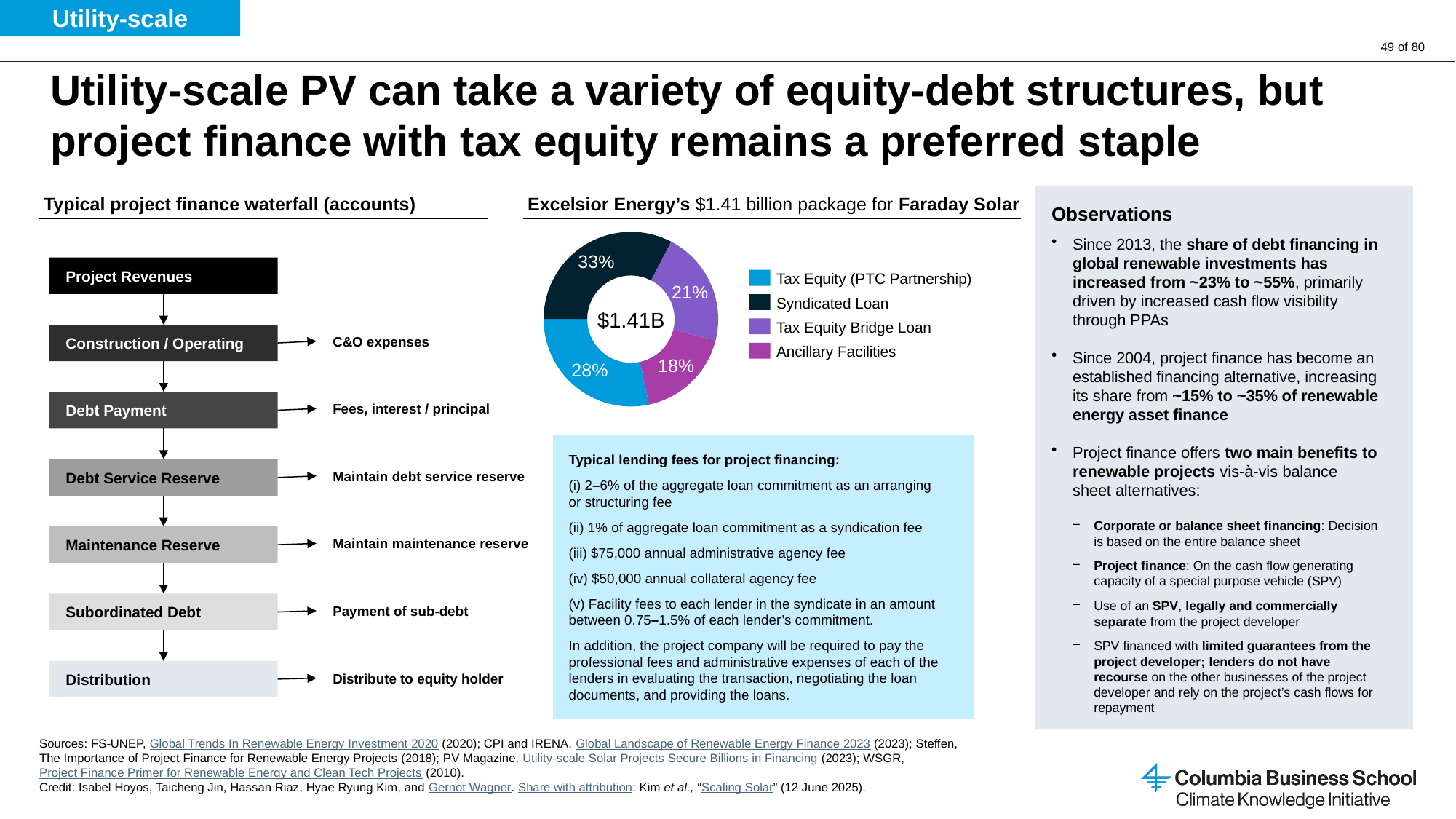
In the Faraday Solar package chart, what share is Ancillary Facilities? 18% In the Faraday Solar package chart, what is the combined share of Tax Equity (PTC Partnership) and Tax Equity Bridge Loan? 49% In the Faraday Solar package chart, what share is Tax Equity Bridge Loan? 21% What total value is shown in the center of the Faraday Solar package donut chart? $1.41B How many components does the legend of the Faraday Solar package chart list? 4 In the Faraday Solar package chart, what share is Tax Equity (PTC Partnership)? 28% What type of chart is used to show Excelsior Energy's $1.41 billion package for Faraday Solar? Pie chart (donut) In the Faraday Solar package chart, how many percentage points larger is Syndicated Loan than Ancillary Facilities? 15 percentage points In the Faraday Solar package chart, which is larger: Tax Equity (PTC Partnership) or Tax Equity Bridge Loan? Tax Equity (PTC Partnership) Which component has the smallest share of the Faraday Solar financing package? Ancillary Facilities Which component has the largest share of the Faraday Solar financing package? Syndicated Loan In the Faraday Solar package chart, what share is Syndicated Loan? 33%